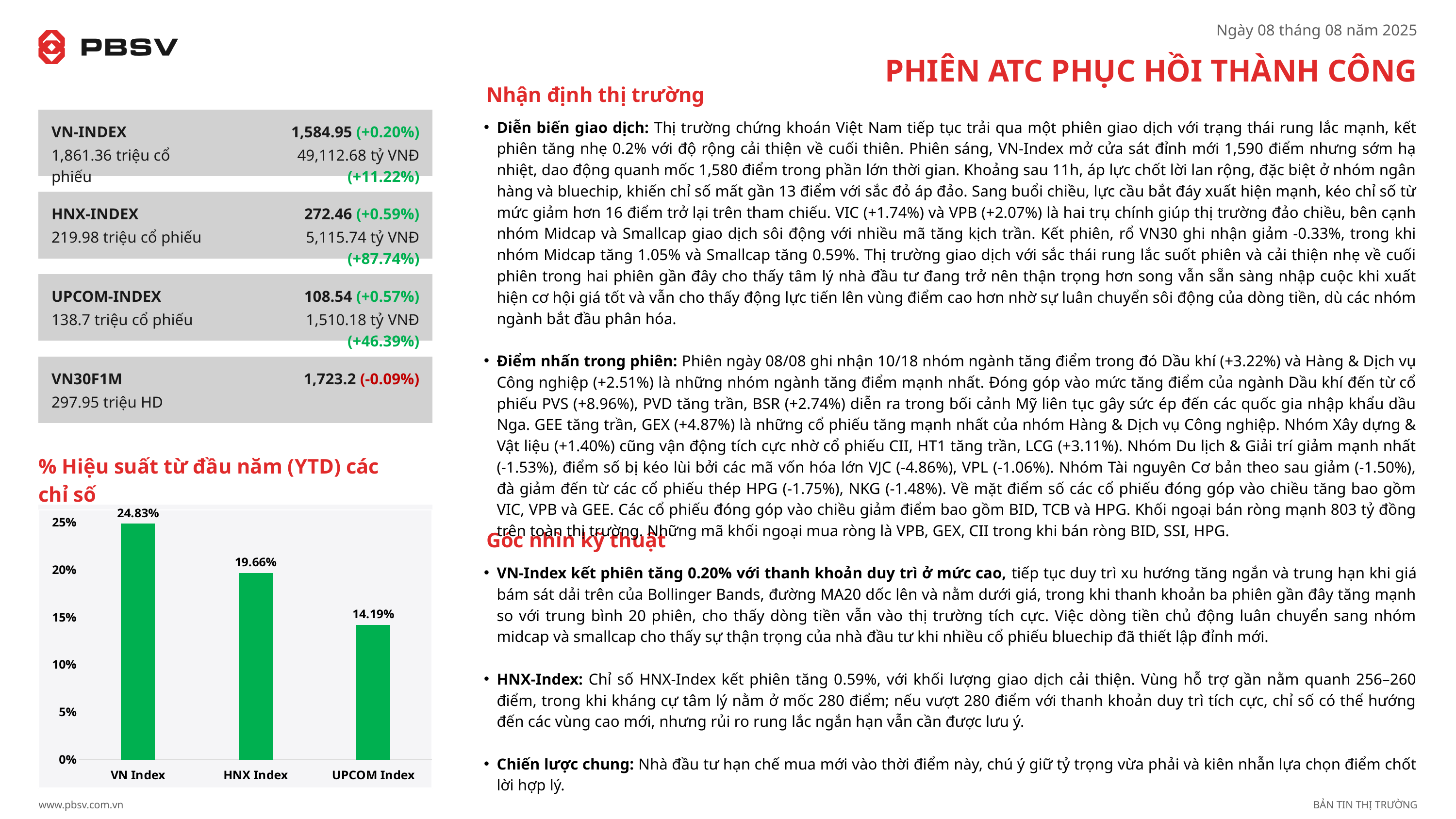
What is the difference between the YTD performance of HNX Index and UPCOM Index? 5.47% What is the YTD performance value for HNX Index? 19.66% What is the YTD performance value for VN Index? 24.83% What type of chart is used to show the YTD performance of the indices? Bar chart Do the YTD performance values rise or fall from left to right across the chart? Fall Which index has the highest YTD performance in the chart? VN Index What is the YTD performance value for UPCOM Index? 14.19% What is the difference between the YTD performance of VN Index and HNX Index? 5.17% Is the YTD performance for UPCOM Index greater or less than 15%? less How many indices are shown in the YTD performance chart? 3 Which index has the lowest YTD performance in the chart? UPCOM Index Which has a larger YTD performance, HNX Index or UPCOM Index? HNX Index